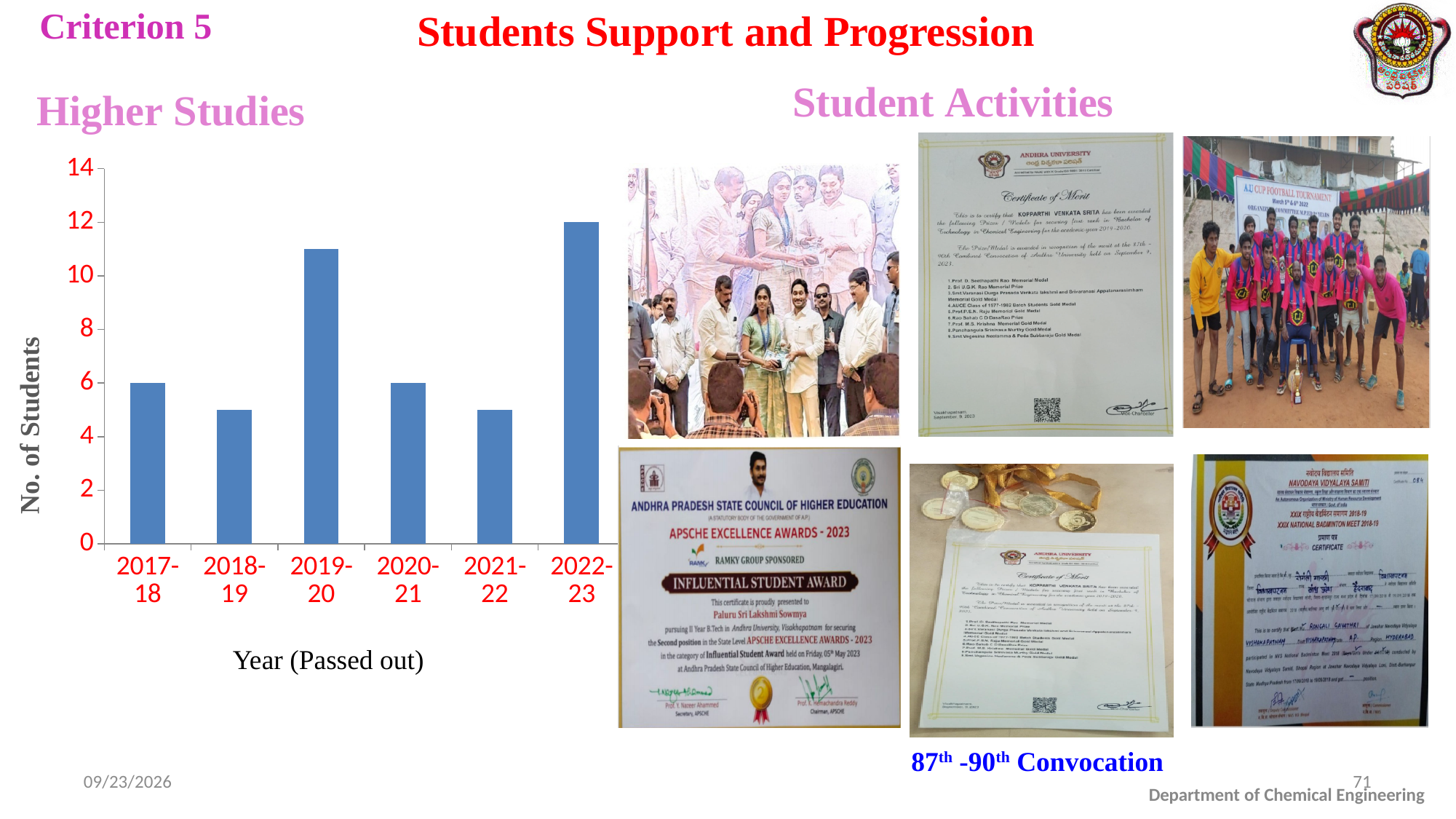
In the Higher Studies chart, is the value for 2019-20 greater or less than 10? greater In the Higher Studies chart, what is the number of students for 2017-18? 6 In the Higher Studies chart, which passed-out year has the highest number of students? 2022-23 How many passed-out years are shown on the x axis of the Higher Studies chart? 6 In the Higher Studies chart, how many students went for higher studies in 2022-23? 12 In the Higher Studies chart, is the value for 2018-19 greater or less than 6? less What is the label of the y axis in the Higher Studies chart? No. of Students In the Higher Studies chart, which year has more students, 2019-20 or 2022-23? 2022-23 In the Higher Studies chart, is the value for 2021-22 greater or less than 4? greater What type of chart is shown under the heading "Higher Studies"? bar chart In the Higher Studies chart, what is the difference between the number of students in 2022-23 and 2017-18? 6 In the Higher Studies chart, what is the number of students for 2020-21? 6